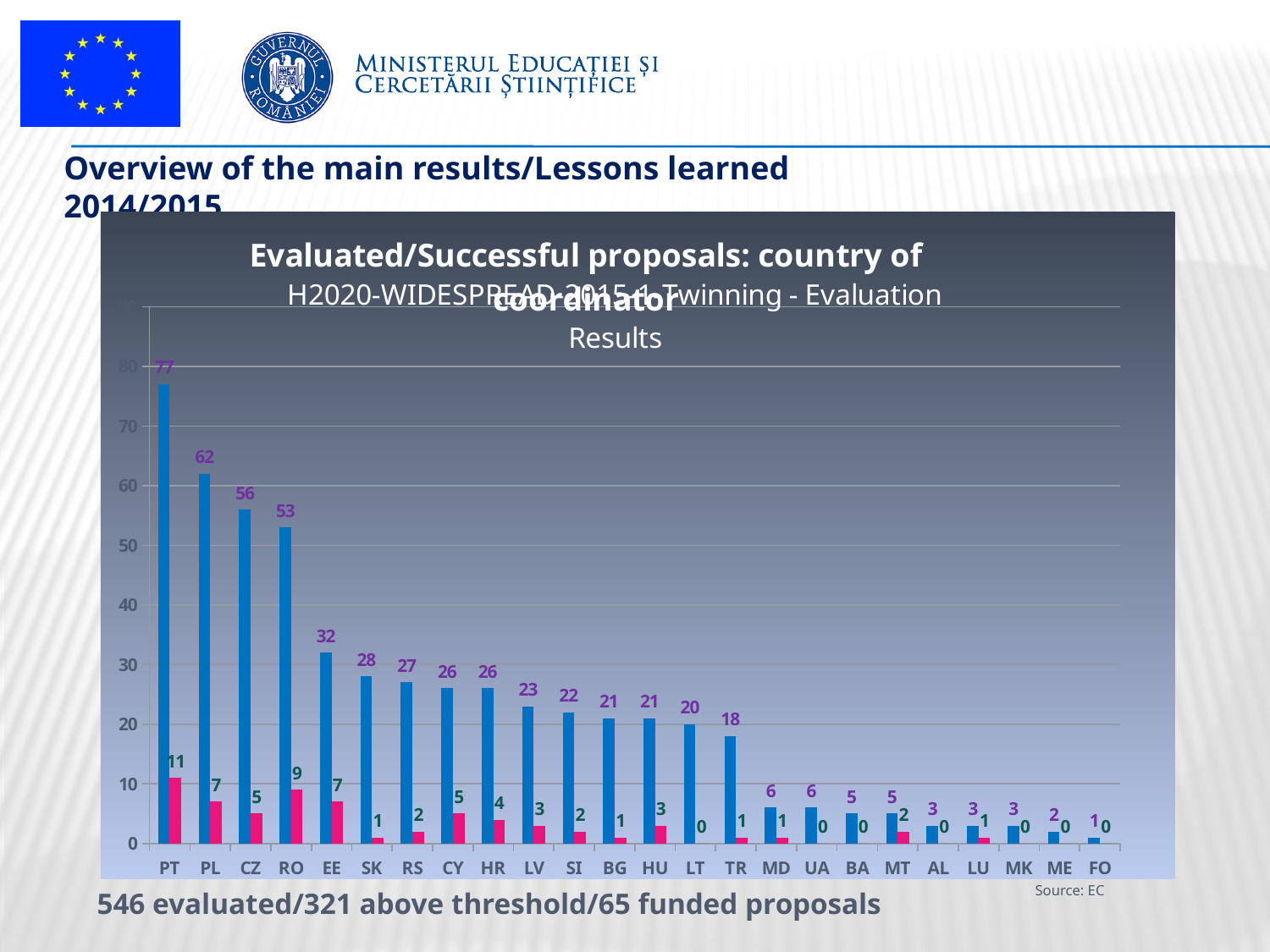
Which country has the highest blue bar? PT How many countries are shown on the x axis? 24 What is the difference between the blue bar values for PL and CZ? 6 What kind of chart is shown on the slide? bar chart What is the value of the blue bar for PT? 77 What is the value of the blue bar for EE? 32 What is the value of the pink bar for LT? 0 Which country has the lowest blue bar? FO Is the blue bar for RO greater or less than 50? greater Which is larger, the pink bar for PT or the pink bar for PL? PT What is the value of the pink bar for RO? 9 Do the blue bar values rise or fall from PT to FO along the x axis? fall